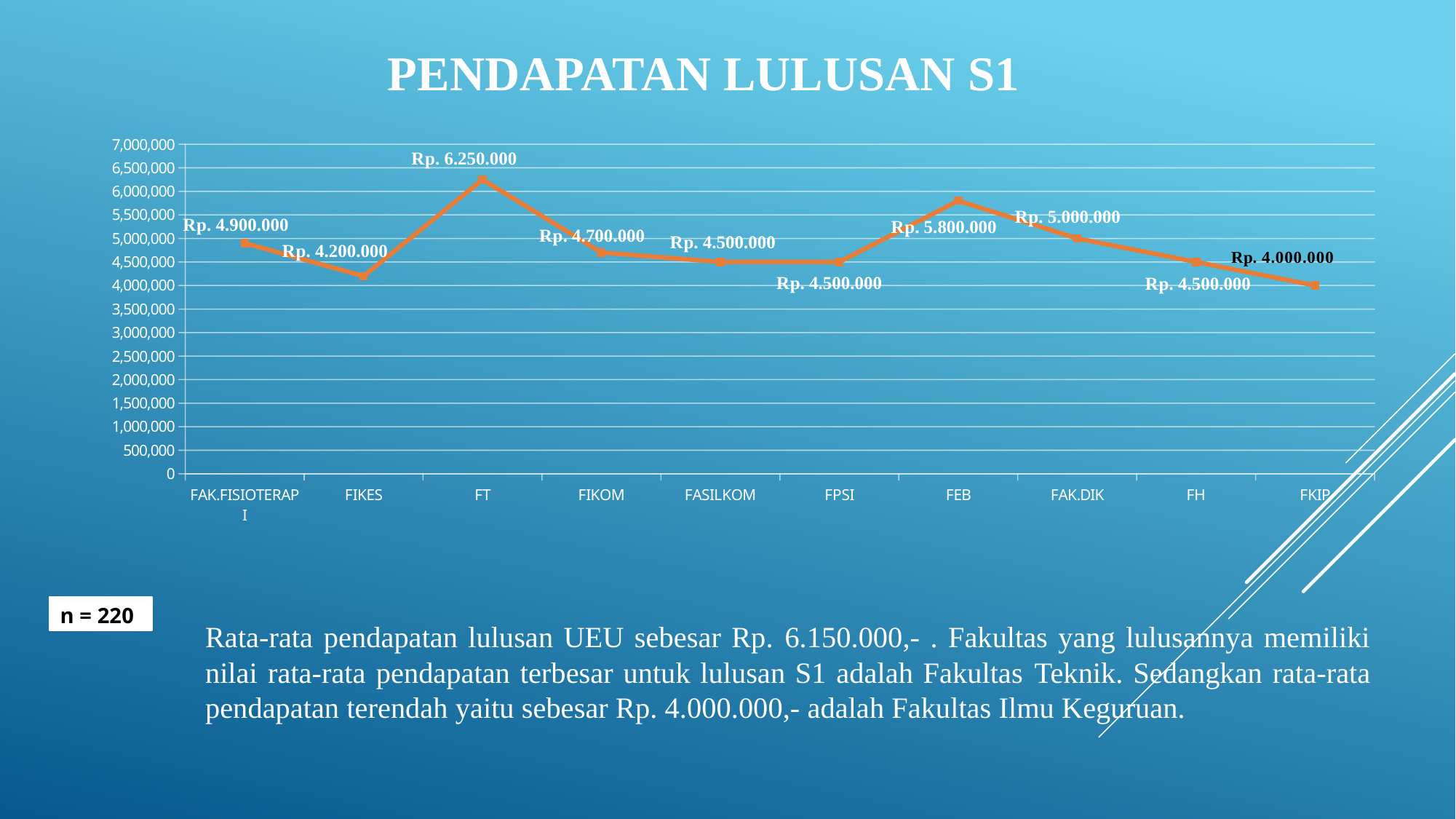
What is the value for FIKES? Rp. 4.200.000 What is the value for FEB? Rp. 5.800.000 How many categories are shown on the x axis? 10 What kind of chart is shown on the slide? line chart Which category has the lowest value? FKIP What is the title of the chart? PENDAPATAN LULUSAN S1 What is the value for FAK.DIK? Rp. 5.000.000 What is the value for FT? Rp. 6.250.000 Is the value for FIKOM greater or less than 5,000,000? less Which is larger, the value for FEB or the value for FAK.DIK? FEB Which category has the highest value? FT What is the difference between the values for FT and FKIP? Rp. 2.250.000